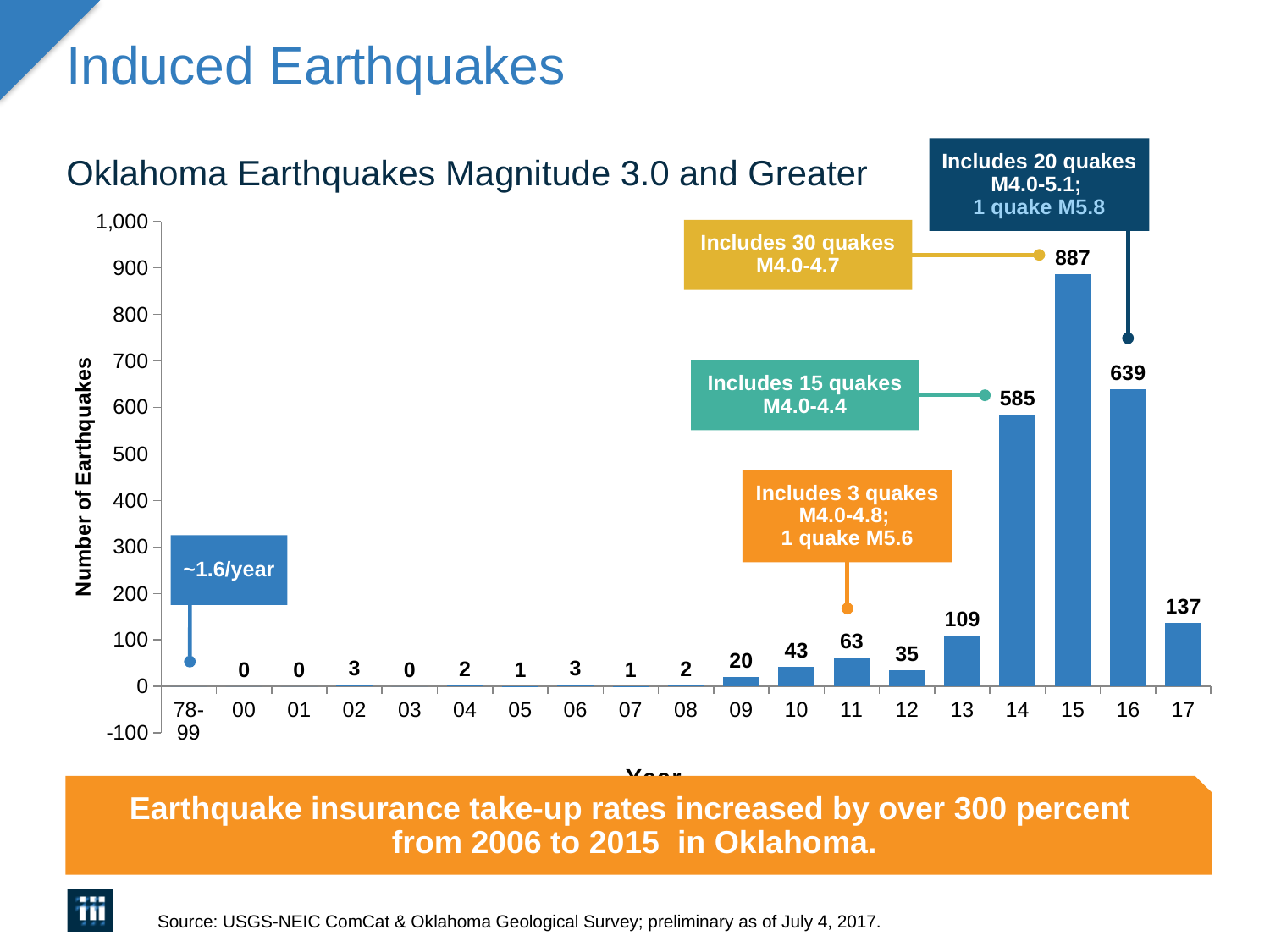
Is the value for 2016 greater or less than 600? greater What is the number of earthquakes shown for 2015? 887 What is the difference between the number of earthquakes in 2015 and 2016? 248 Which year has the highest number of earthquakes? 15 What is the title of the chart? Oklahoma Earthquakes Magnitude 3.0 and Greater Which year has more earthquakes, 2014 or 2016? 16 How many categories are shown on the x axis? 19 What is the number of earthquakes shown for 2017? 137 What kind of chart is shown on the slide? Bar chart What is the number of earthquakes shown for 2014? 585 What is the number of earthquakes shown for 2009? 20 What is the difference between the number of earthquakes in 2013 and 2012? 74